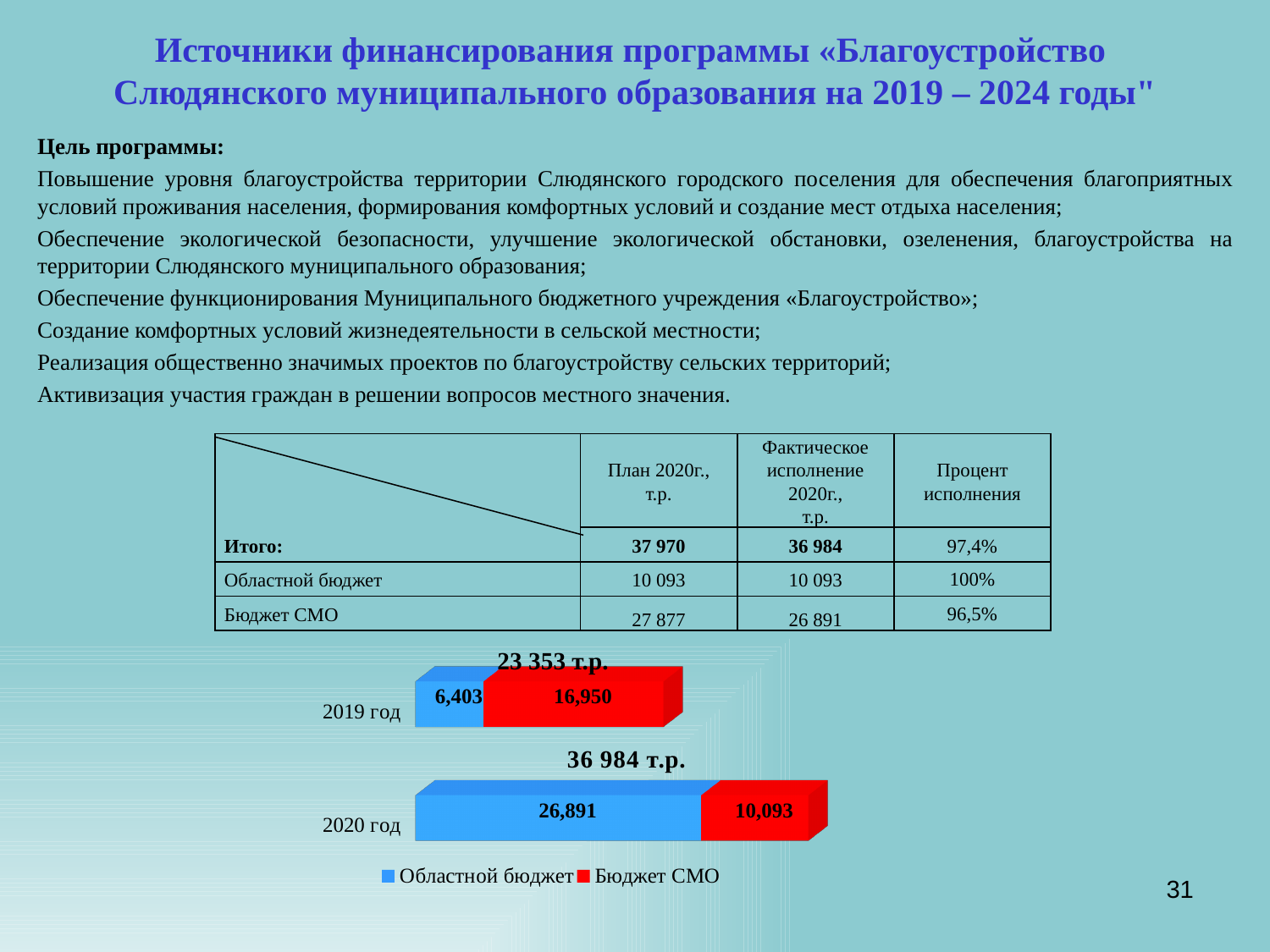
In the bar chart, what value is shown on the red segment of the 2020 год bar? 10,093 In the bar chart, what is the value of Бюджет СМО for 2019 год? 16,950 In the bar chart, which is larger for 2019 год: Областной бюджет or Бюджет СМО? Бюджет СМО Which year has the larger total in the bar chart, 2019 год or 2020 год? 2020 год In the bar chart, what total is printed above the 2020 год bar? 36 984 т.р. In the bar chart, what value is shown on the blue segment of the 2020 год bar? 26,891 In the bar chart, what is the value of Областной бюджет for 2019 год? 6,403 What kind of chart is shown at the bottom of the slide? stacked bar chart How many years (categories) are shown in the bar chart? 2 How many series does the legend of the bar chart list? 2 In the bar chart, what is the difference between the 2020 год total and the 2019 год total? 13 631 т.р. In the bar chart, what total is printed above the 2019 год bar? 23 353 т.р.